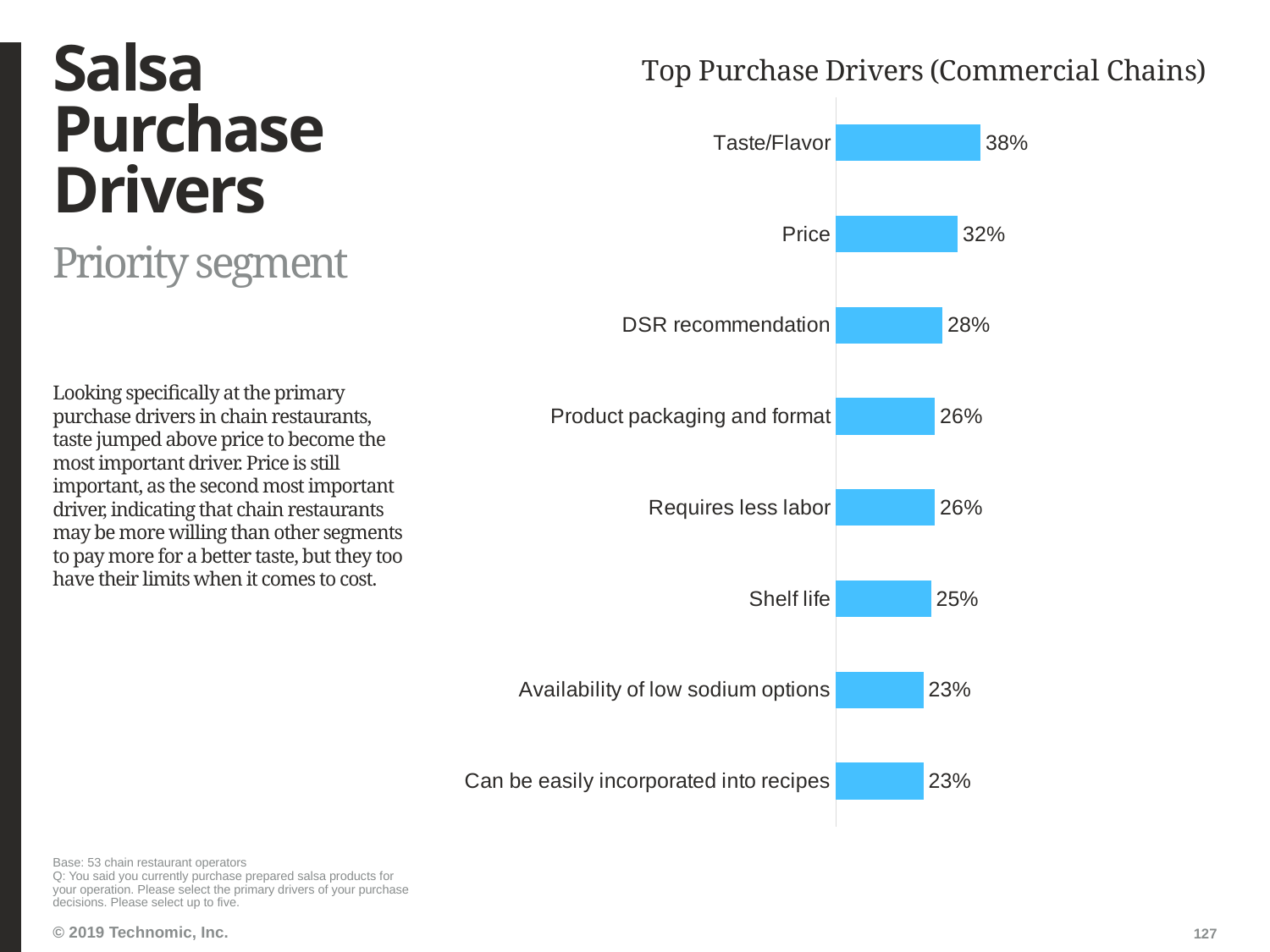
What kind of chart is shown on the slide? Bar chart What is the difference between the values for Price and Shelf life? 7% What is the value for DSR recommendation? 28% What is the value for Availability of low sodium options? 23% Which purchase driver has the highest value? Taste/Flavor What is the difference between the values for Taste/Flavor and Price? 6% What is the value for Taste/Flavor? 38% How many purchase drivers are shown in the chart? 8 What colour are the bars in the chart? Blue Which is larger, the value for Price or the value for Requires less labor? Price What is the value for Shelf life? 25% What is the title of the chart? Top Purchase Drivers (Commercial Chains)